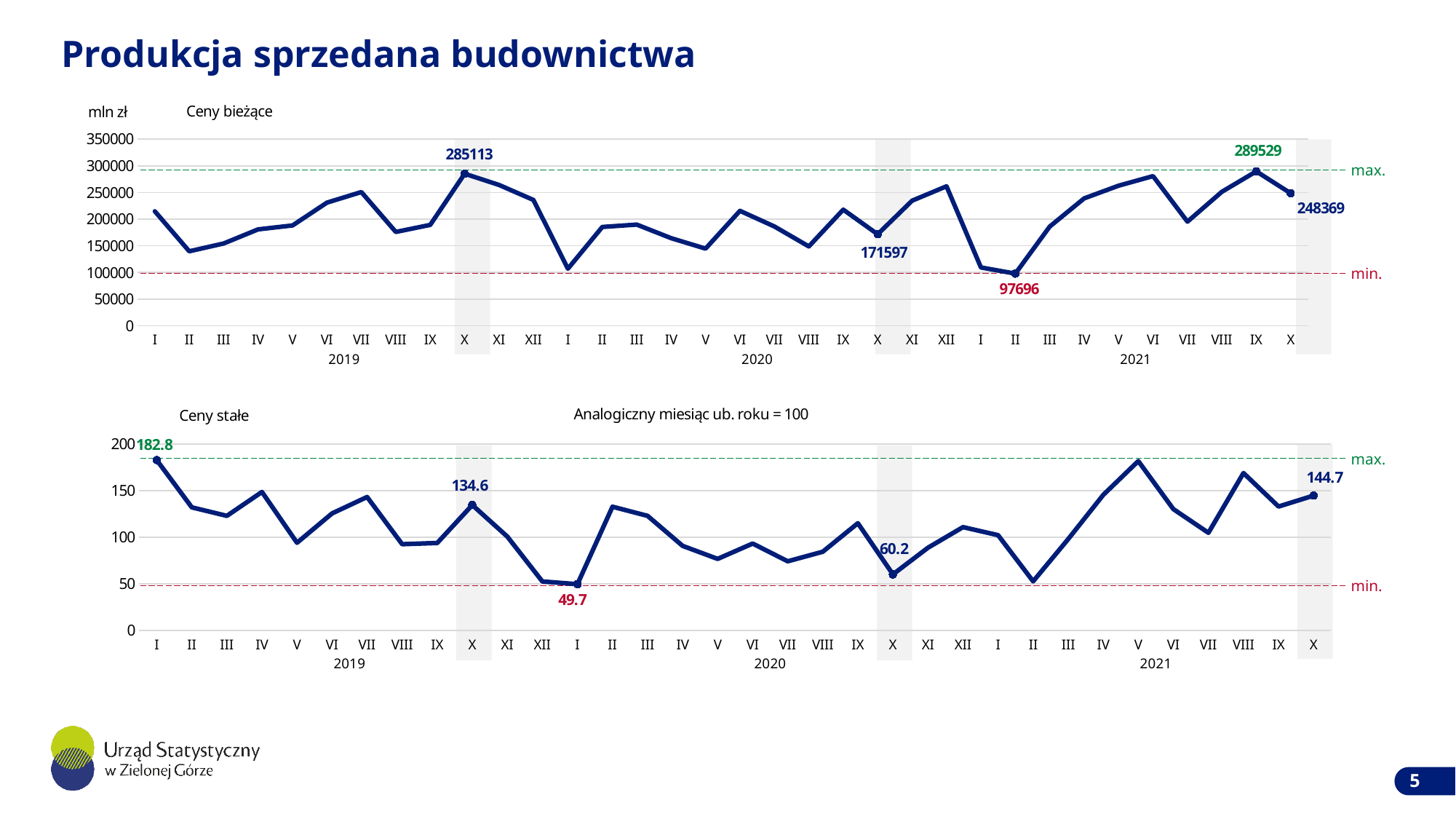
In the top chart (Ceny bieżące), what unit is shown on the vertical axis? mln zł In the bottom chart (Ceny stałe), which is larger: the value for X 2020 or the value for X 2021? X 2021 In the bottom chart (Ceny stałe), what is the value for January (I) 2019? 182.8 In the top chart (Ceny bieżące), what is the value for October (X) 2021? 248369 In the top chart (Ceny bieżące), what is the maximum value shown? 289529 In the top chart (Ceny bieżące), is the value for XII 2020 greater or less than 250000? greater In the top chart (Ceny bieżące), which month has the lowest value? II 2021 In the bottom chart (Ceny stałe), what is the difference between the value for X 2021 and the value for X 2020? 84.5 In the bottom chart (Ceny stałe), which month has the lowest value? I 2020 In the top chart (Ceny bieżące), what is the difference between the value for X 2019 and the value for X 2020? 113516 What type of chart is used on this slide? Line chart In the top chart (Ceny bieżące), what is the value for October (X) 2019? 285113